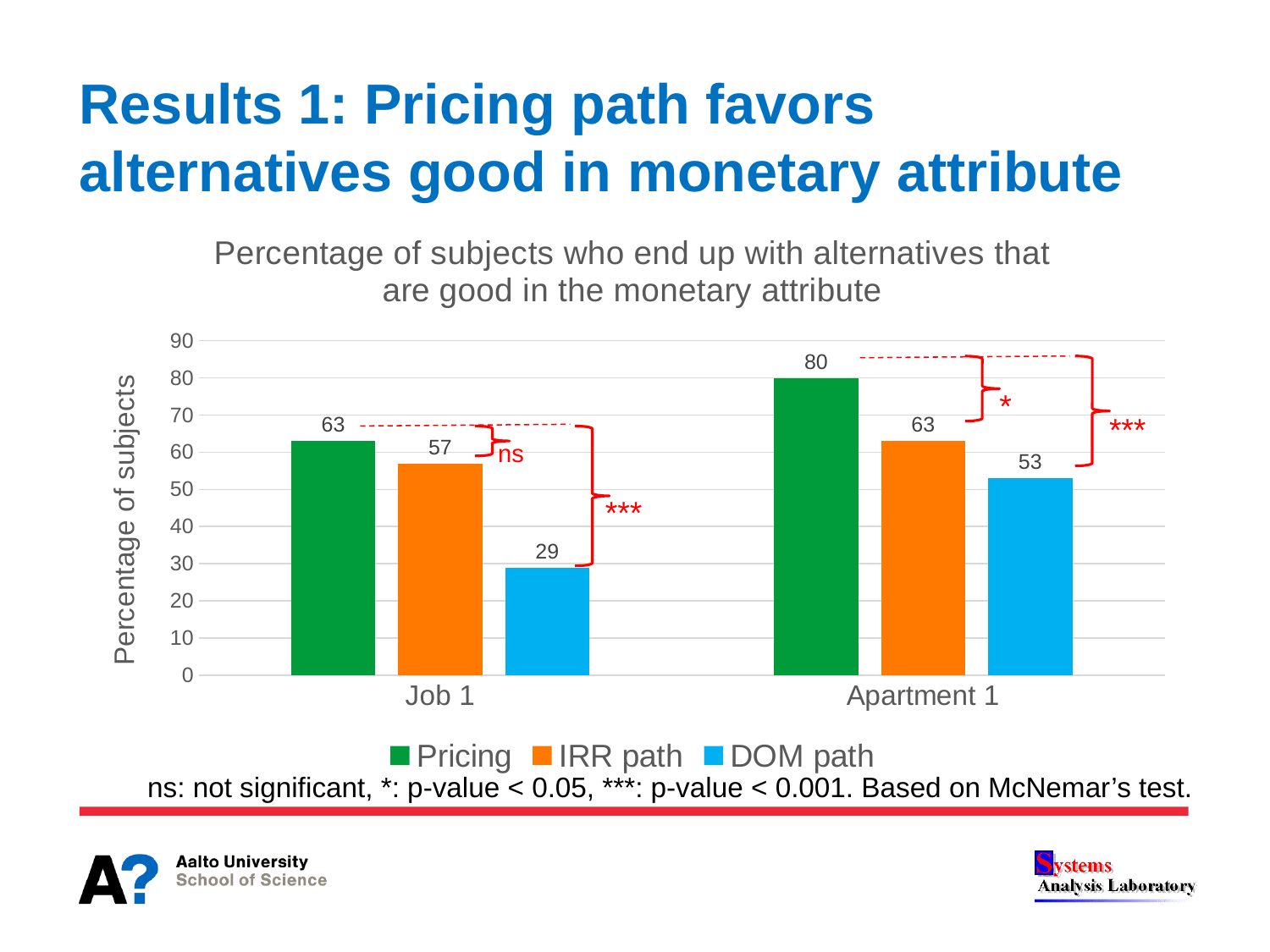
How many series does the legend list? 3 What is the label of the y axis? Percentage of subjects What is the difference between the Pricing values for Apartment 1 and Job 1? 17 What is the value for DOM path in the Apartment 1 category? 53 What is the difference between the Pricing and DOM path values in the Job 1 category? 34 Which series has the highest value in the Apartment 1 category? Pricing Which is larger: the DOM path value for Job 1 or the DOM path value for Apartment 1? Apartment 1 What is the value for Pricing in the Job 1 category? 63 How many categories are shown on the x axis? 2 What kind of chart is shown on the slide? Bar chart What is the value for IRR path in the Job 1 category? 57 Which series has the lowest value in the Job 1 category? DOM path